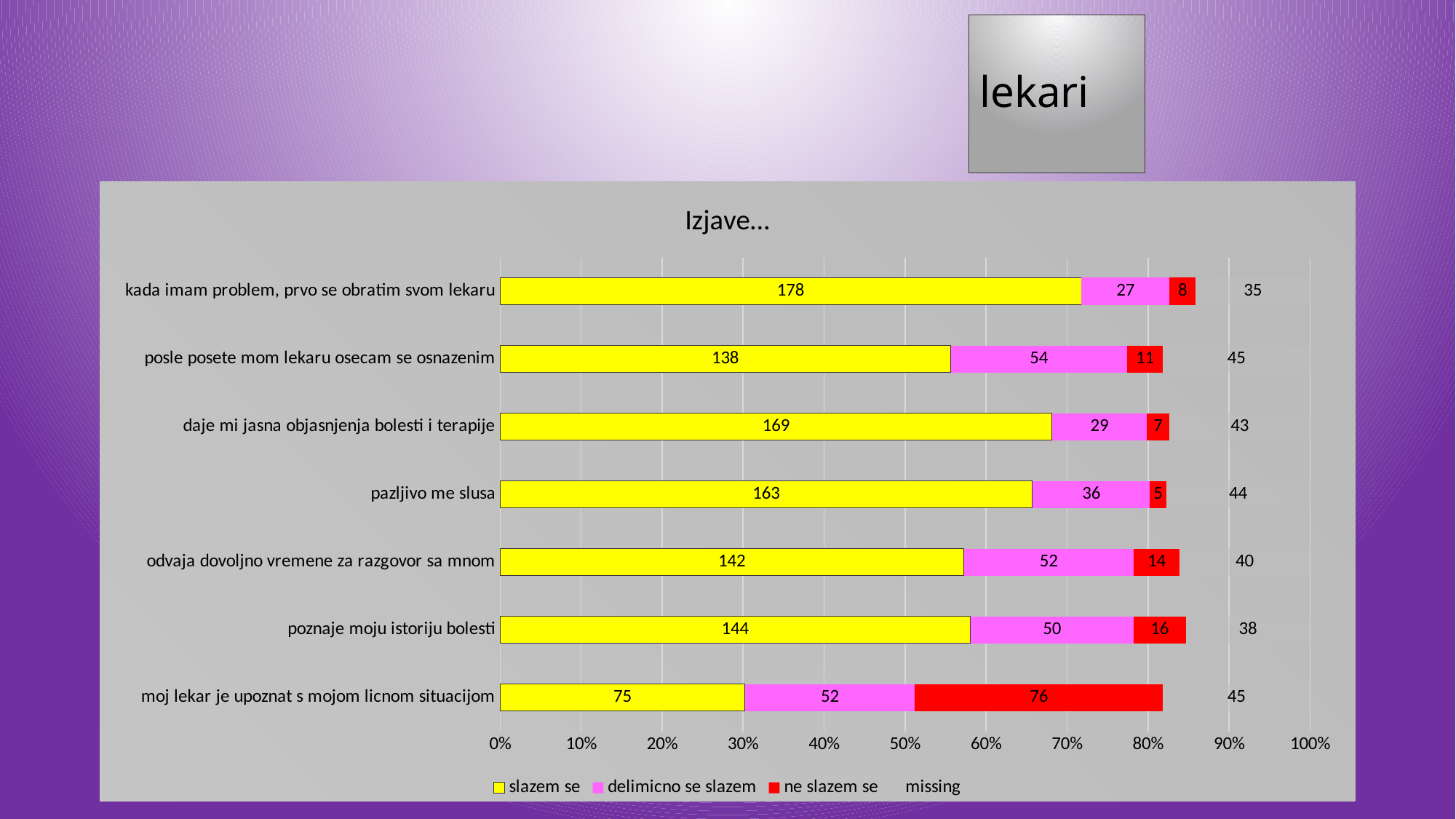
Which has the larger "delimicno se slazem" value: "odvaja dovoljno vremene za razgovor sa mnom" or "pazljivo me slusa"? odvaja dovoljno vremene za razgovor sa mnom What kind of chart is shown on the slide? Stacked bar chart How many series does the legend list? 4 What is the "missing" value for "kada imam problem, prvo se obratim svom lekaru"? 35 What is the value of "delimicno se slazem" for "posle posete mom lekaru osecam se osnazenim"? 54 What is the total of all four values (slazem se, delimicno se slazem, ne slazem se, missing) for "pazljivo me slusa"? 248 How many statements (categories) are shown in the chart? 7 Which statement has the lowest "slazem se" value? moj lekar je upoznat s mojom licnom situacijom What is the difference between the "ne slazem se" values for "moj lekar je upoznat s mojom licnom situacijom" and "pazljivo me slusa"? 71 What is the value of "ne slazem se" for "poznaje moju istoriju bolesti"? 16 Which statement has the highest "slazem se" value? kada imam problem, prvo se obratim svom lekaru What is the value of "slazem se" for "pazljivo me slusa"? 163